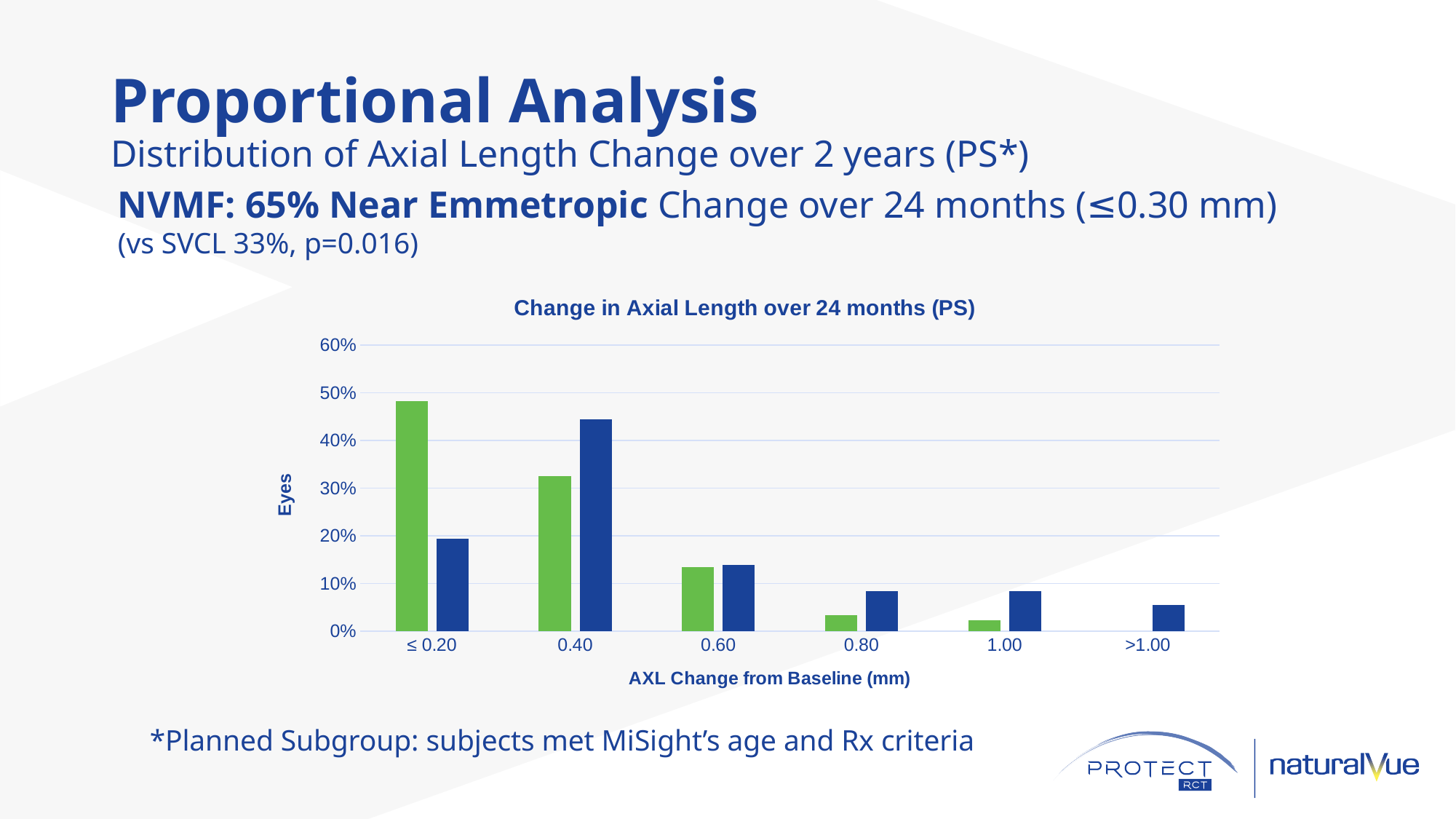
Is the value of the green bar for ≤ 0.20 greater or less than 40%? greater Is the value of the blue bar for ≤ 0.20 greater or less than 30%? less Which category has the tallest blue bar? 0.40 What is the label of the x axis of the chart? AXL Change from Baseline (mm) Do the green bars rise or fall moving from ≤ 0.20 to 1.00 along the x axis? fall What is the title of the chart? Change in Axial Length over 24 months (PS) What kind of chart is shown on the slide? bar chart Which category has the tallest green bar? ≤ 0.20 Is the value of the blue bar for 0.40 greater or less than 40%? greater For the ≤ 0.20 category, which bar is taller, the green one or the blue one? green How many categories are shown on the x axis of the chart? 6